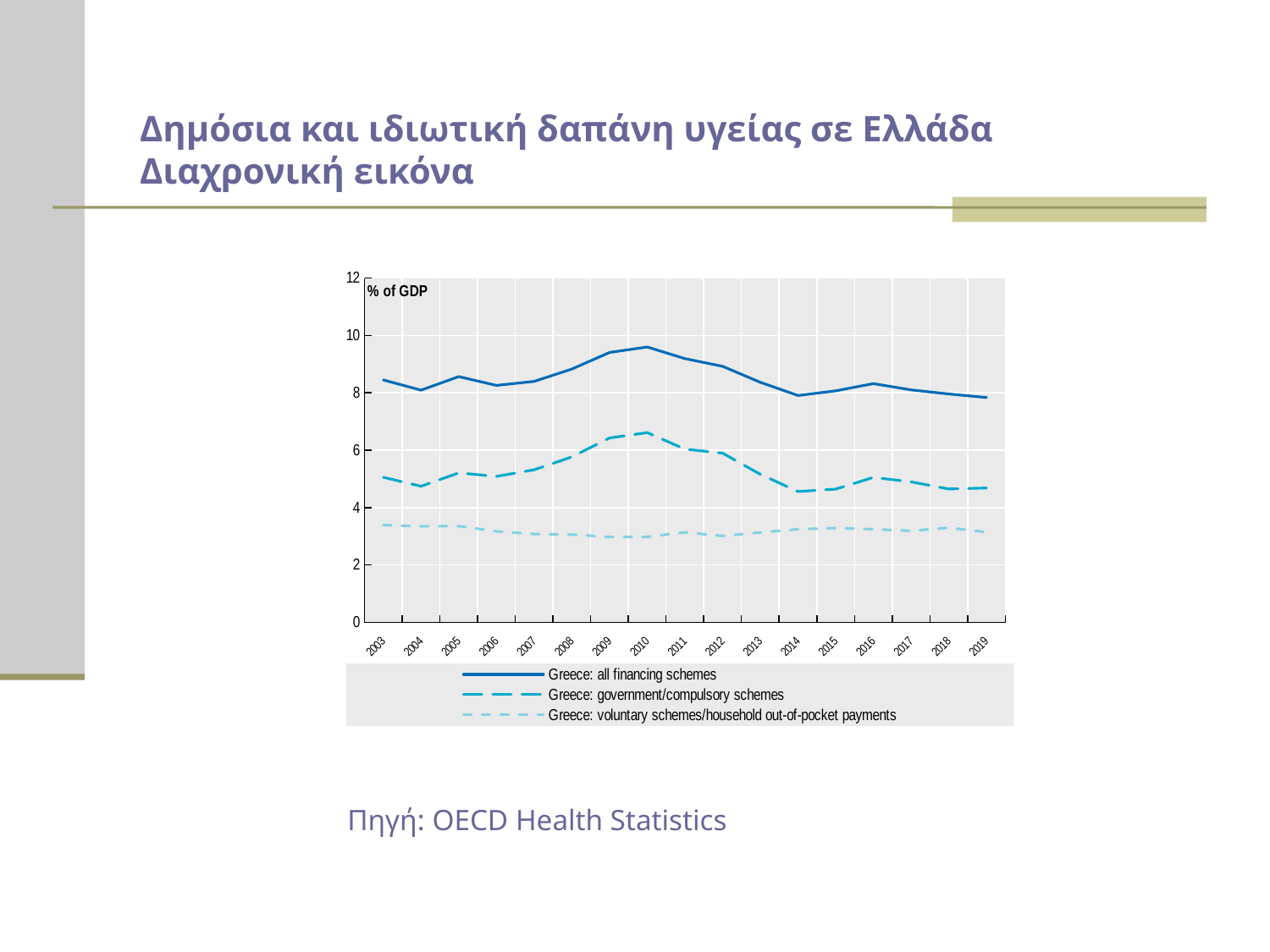
Between 2010 and 2014, does the 'Greece: all financing schemes' series rise or fall? fall What unit label is printed inside the top-left of the plot area? % of GDP Is the value for 'Greece: voluntary schemes/household out-of-pocket payments' in 2010 greater or less than 4? less What is the first year shown on the x axis? 2003 What kind of chart is shown on the slide? line chart How many series does the legend list? 3 In 2010, which series is larger: 'Greece: government/compulsory schemes' or 'Greece: voluntary schemes/household out-of-pocket payments'? Greece: government/compulsory schemes Is the value for 'Greece: government/compulsory schemes' in 2010 greater or less than 6? greater Is the value for 'Greece: all financing schemes' in 2010 greater or less than 8? greater In which year does the 'Greece: all financing schemes' series reach its highest value? 2010 In which year does the 'Greece: government/compulsory schemes' series reach its highest value? 2010 How many years are shown along the x axis? 17